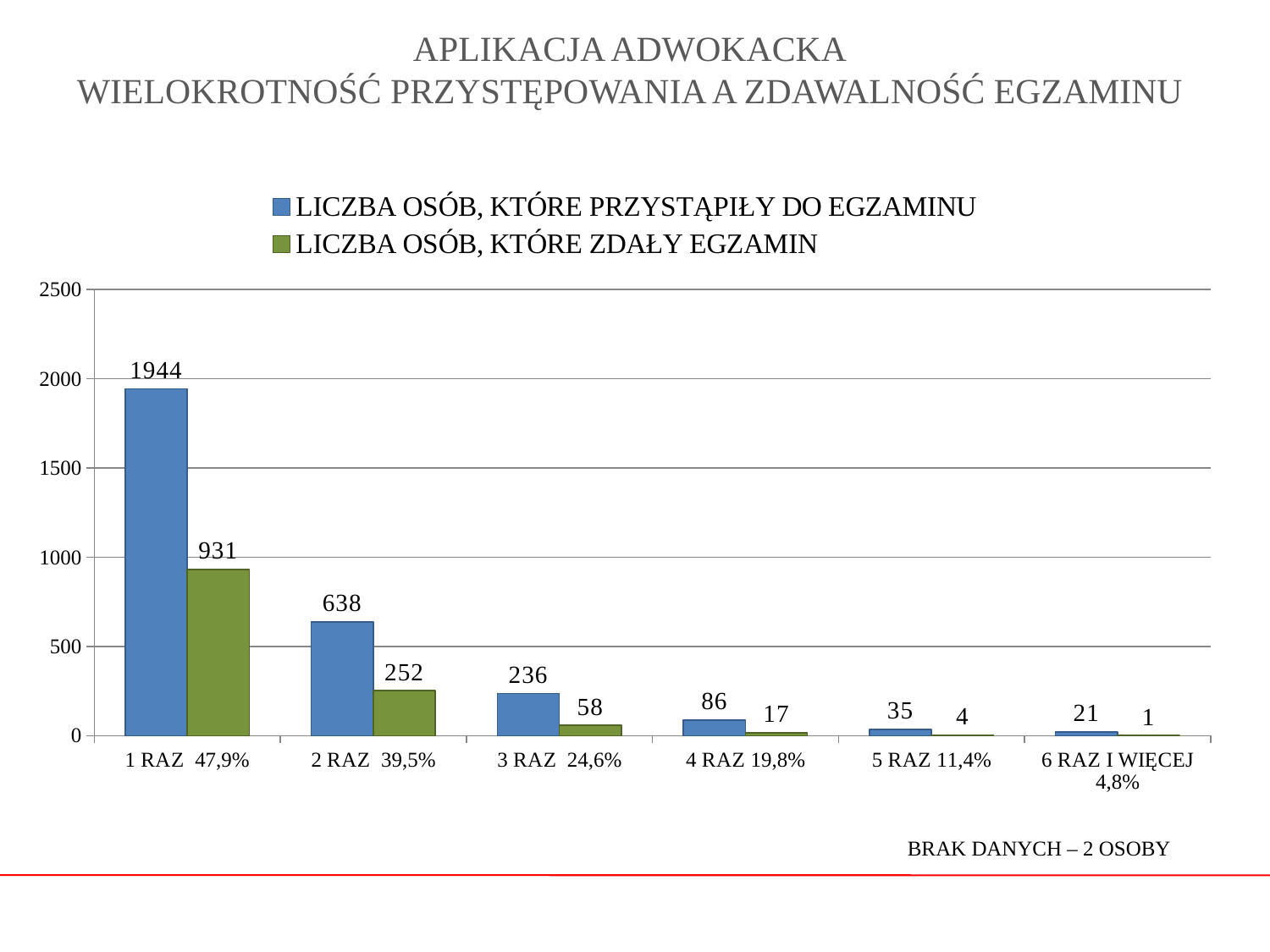
Do the values for LICZBA OSÓB, KTÓRE PRZYSTĄPIŁY DO EGZAMINU rise or fall along the x axis? fall What is the value of LICZBA OSÓB, KTÓRE ZDAŁY EGZAMIN for 6 RAZ I WIĘCEJ 4,8%? 1 How many people took the exam for the first time (1 RAZ 47,9%)? 1944 Which is larger: the number who passed in 3 RAZ 24,6% or the number who took the exam in 5 RAZ 11,4%? 3 RAZ 24,6% passed (58) Which category has the highest number of people who took the exam? 1 RAZ 47,9% How many categories are shown on the x axis? 6 How many series does the legend list? 2 Which category has the lowest number of people who passed the exam? 6 RAZ I WIĘCEJ 4,8% What kind of chart is shown on the slide? bar chart What is the value of LICZBA OSÓB, KTÓRE PRZYSTĄPIŁY DO EGZAMINU for 4 RAZ 19,8%? 86 What is the difference between the number of people who took the exam and the number who passed in the 1 RAZ 47,9% category? 1013 How many people passed the exam in the 2 RAZ 39,5% category? 252